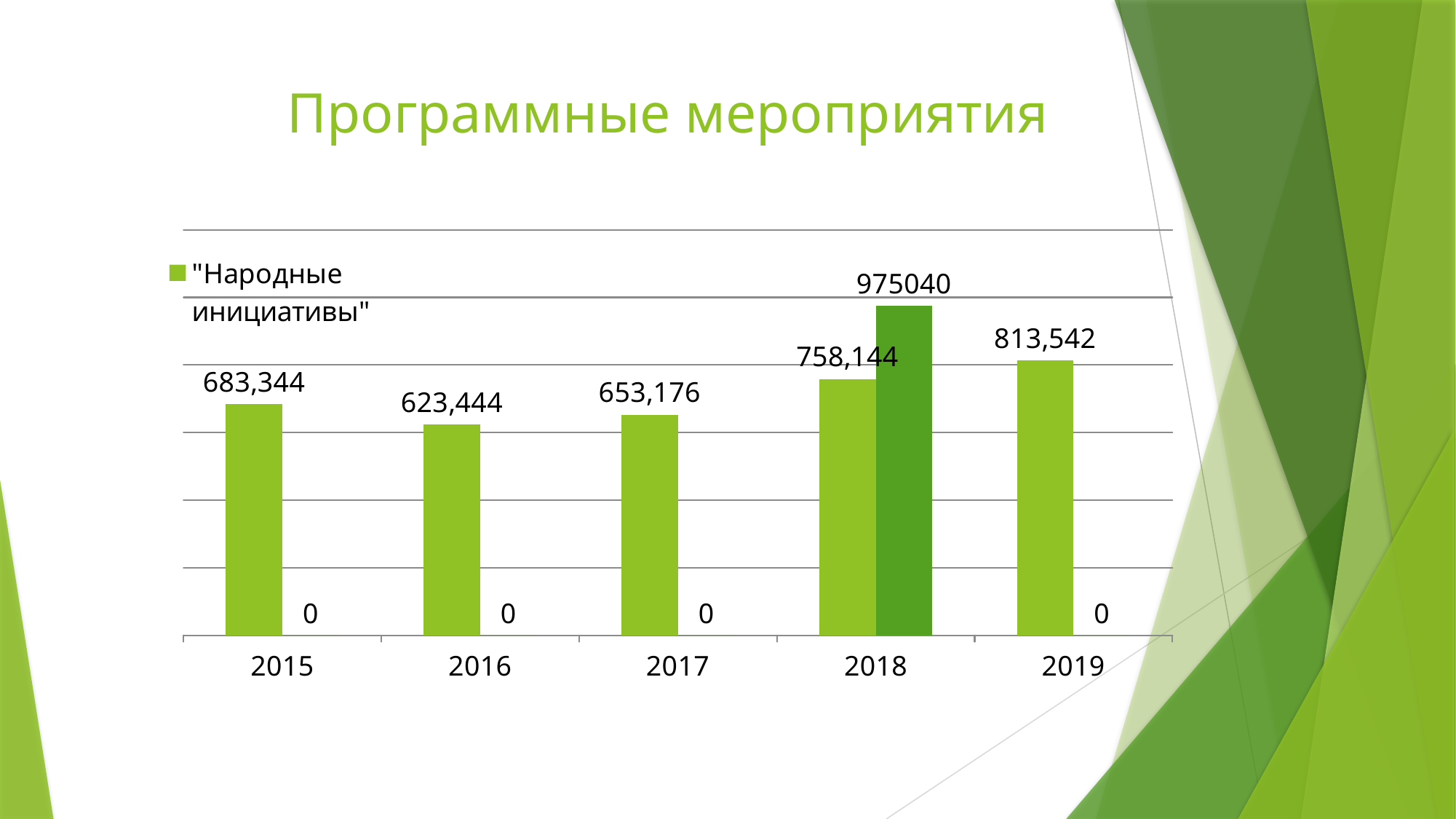
Which year has the highest "Народные инициативы" value? 2019 Which is larger, the "Народные инициативы" value for 2015 or for 2017? 2015 Do the "Народные инициативы" values rise or fall from 2016 to 2019? rise What is the difference between the "Народные инициативы" values for 2019 and 2015? 130,198 What kind of chart is shown on the slide? bar chart What is the value of the "Народные инициативы" bar for 2016? 623,444 Which year has the lowest "Народные инициативы" value? 2016 What value is labelled on the dark green bar for 2018? 975040 What is the value of the "Народные инициативы" bar for 2015? 683,344 What is the value of the "Народные инициативы" bar for 2017? 653,176 How many years are shown on the x axis? 5 What is the value of the "Народные инициативы" bar for 2019? 813,542